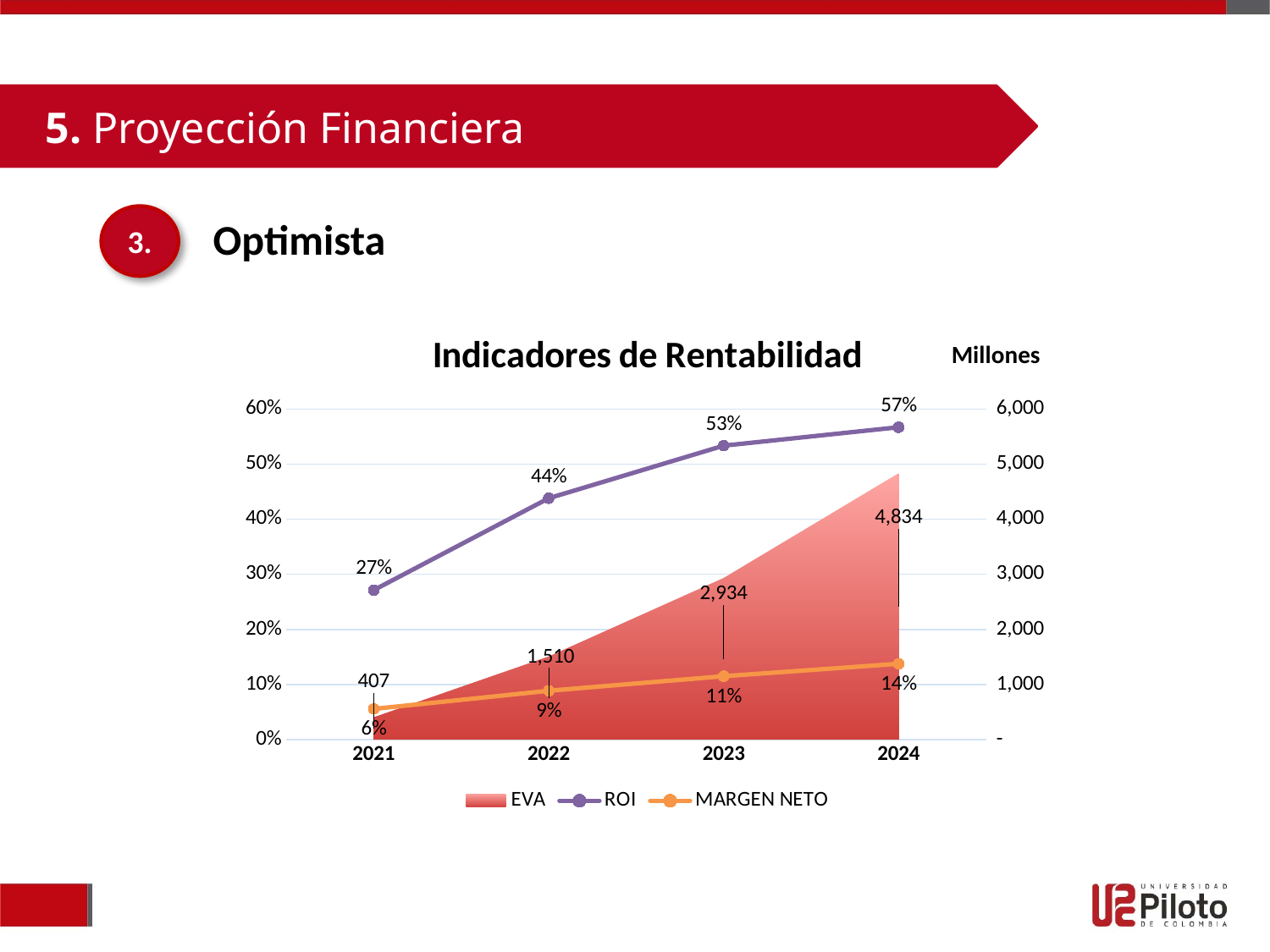
What is the difference between the EVA values for 2024 and 2023 in the 'Indicadores de Rentabilidad' chart? 1,900 What is the title of the chart on the slide? Indicadores de Rentabilidad How many years are shown on the x axis of the 'Indicadores de Rentabilidad' chart? 4 What is the EVA value for 2024 in the 'Indicadores de Rentabilidad' chart? 4,834 What is the difference between the ROI values for 2022 and 2021 in the 'Indicadores de Rentabilidad' chart? 17% What is the ROI value for 2023 in the 'Indicadores de Rentabilidad' chart? 53% What is the MARGEN NETO value for 2022 in the 'Indicadores de Rentabilidad' chart? 9% In which year is the ROI highest in the 'Indicadores de Rentabilidad' chart? 2024 In which year is the EVA lowest in the 'Indicadores de Rentabilidad' chart? 2021 Which is larger in 2023 in the 'Indicadores de Rentabilidad' chart: ROI or MARGEN NETO? ROI How many series does the legend of the 'Indicadores de Rentabilidad' chart list? 3 Does the MARGEN NETO rise or fall from 2021 to 2024 in the 'Indicadores de Rentabilidad' chart? Rise